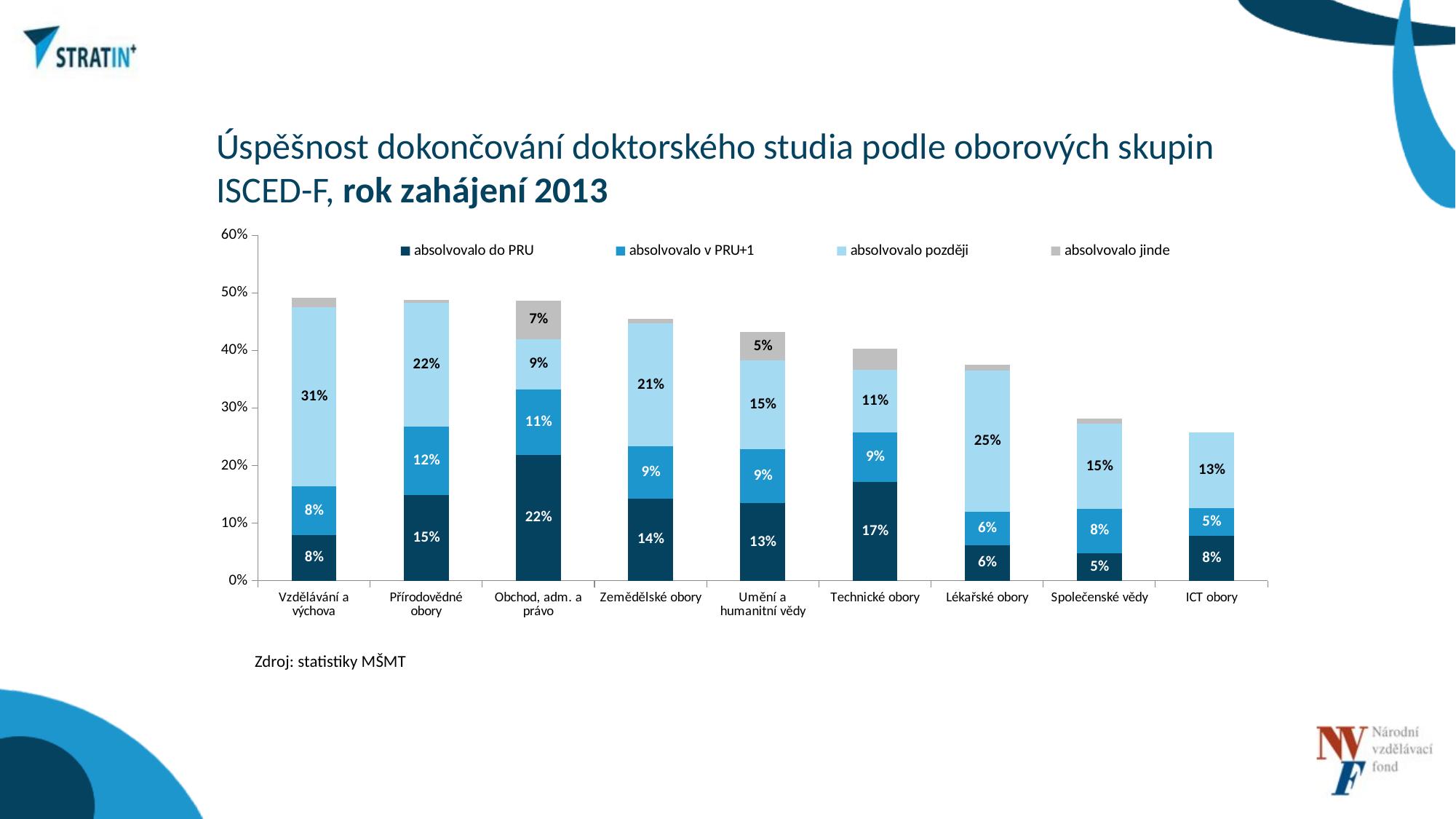
Which field group has the highest value for 'absolvovalo do PRU'? Obchod, adm. a právo How many series does the legend list? 4 What is the value of 'absolvovalo jinde' for Umění a humanitní vědy? 5% How many field groups (categories) are shown on the x axis? 9 What is the difference between the 'absolvovalo později' values for Lékařské obory and ICT obory? 12% What is the value of 'absolvovalo později' for Vzdělávání a výchova? 31% What is the total of the stacked bar for Obchod, adm. a právo? 49% What type of chart is shown on the slide? Stacked bar chart Is the total of the stacked bar for ICT obory greater or less than 30%? less Which field group has the lowest value for 'absolvovalo do PRU'? Společenské vědy What is the value of 'absolvovalo do PRU' for Obchod, adm. a právo? 22% What is the value of 'absolvovalo v PRU+1' for Přírodovědné obory? 12%